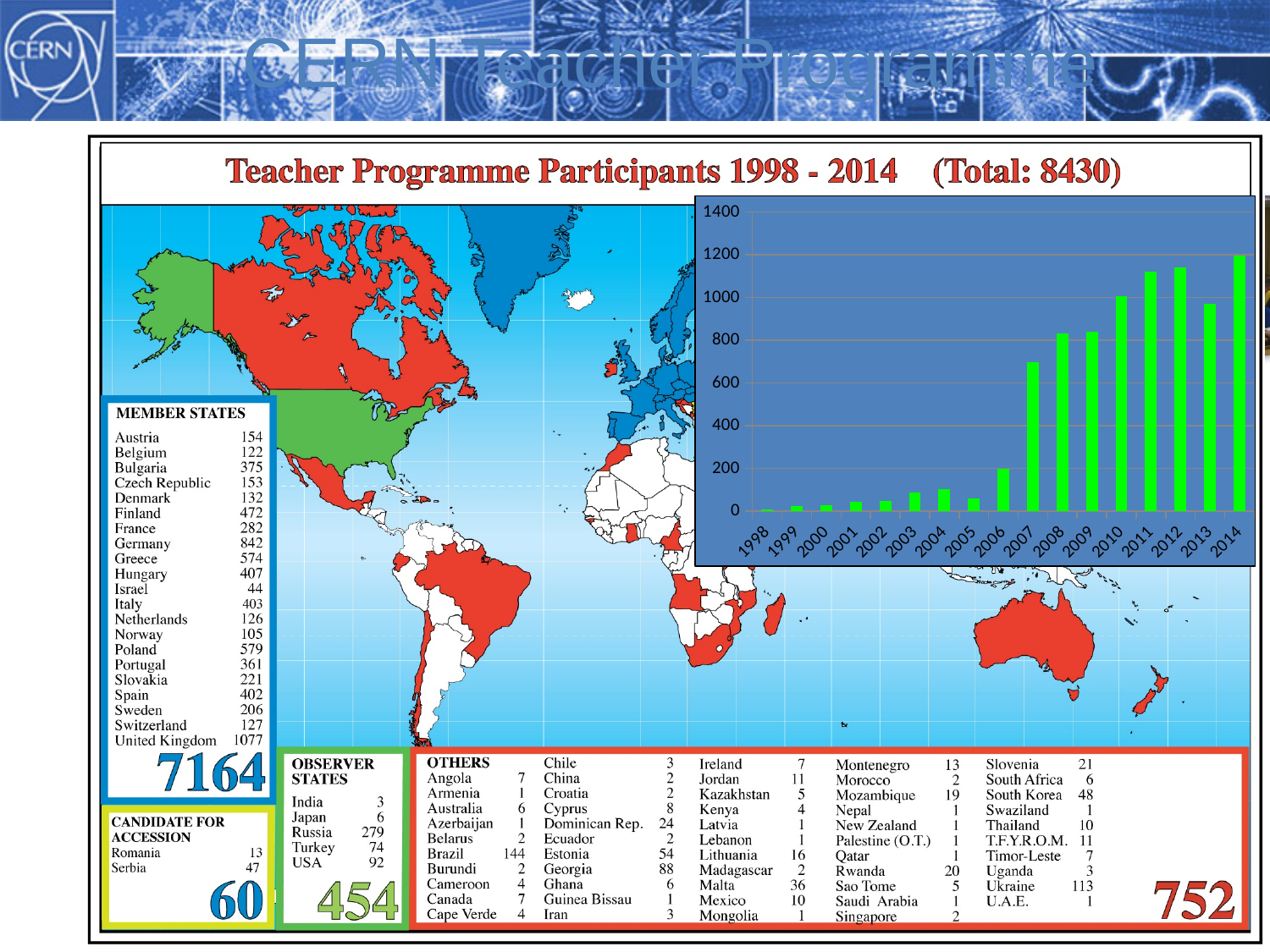
How many years are plotted on the x axis of the bar chart? 17 Is the value for 2007 greater or less than 600? greater What total is given in the title above the chart? 8430 Which year has the tallest bar in the chart? 2014 Which year has the larger value, 2007 or 2008? 2008 Which year has the shortest bar in the chart? 1998 What kind of chart is shown on the slide? bar chart Which year has the larger value, 2012 or 2013? 2012 Do the values in the bar chart generally rise or fall from 1998 to 2014? rise Is the value for 2011 greater or less than 1000? greater Is the value for 2013 greater or less than 1000? less